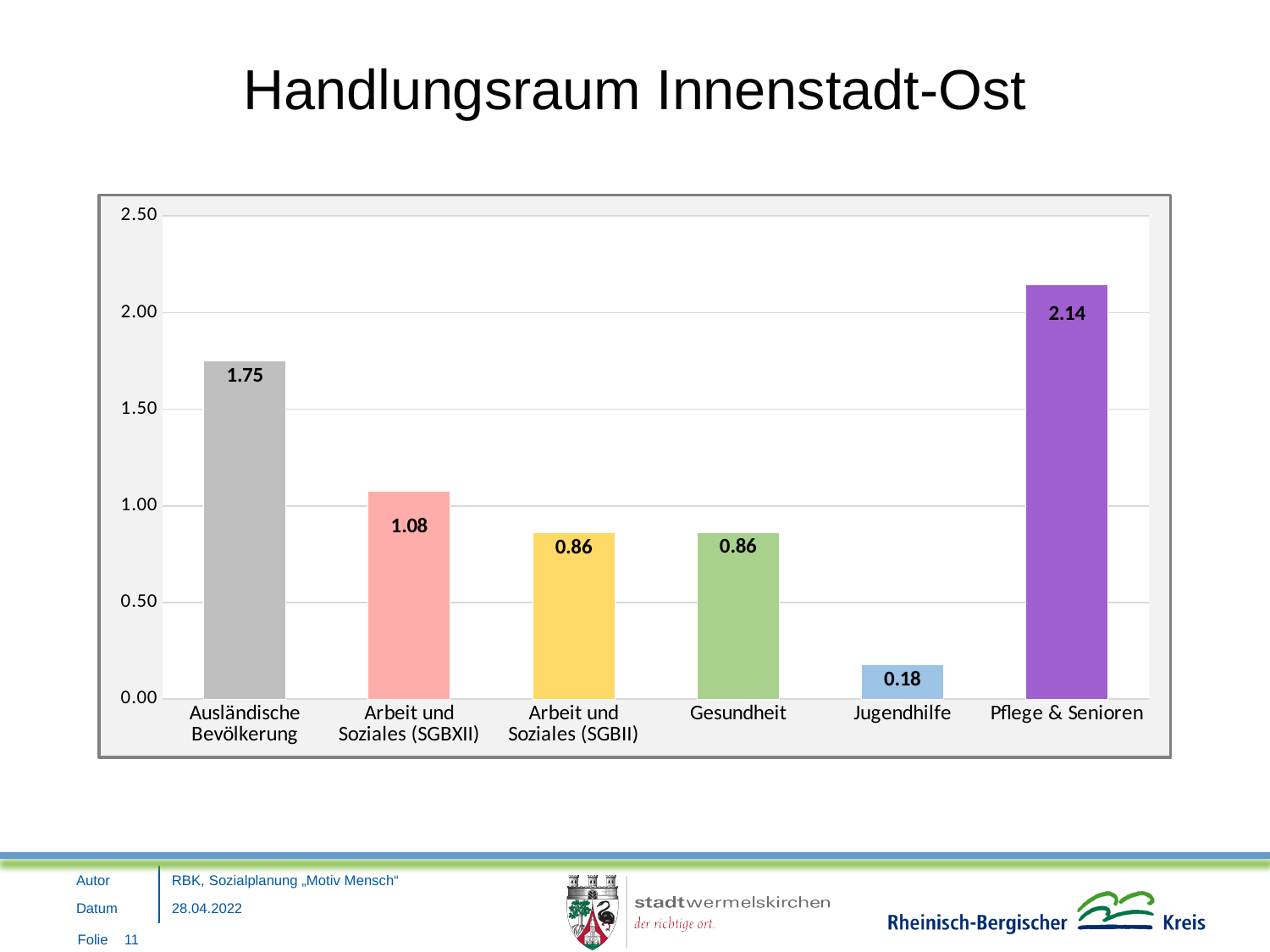
What is the difference between the values for Pflege & Senioren and Ausländische Bevölkerung? 0.39 What is the value for Pflege & Senioren? 2.14 What is the value for Jugendhilfe? 0.18 Which category has the lowest value? Jugendhilfe How many categories are shown on the x axis? 6 What colour is the bar for Pflege & Senioren? Purple Which is larger, the value for Arbeit und Soziales (SGBXII) or the value for Gesundheit? Arbeit und Soziales (SGBXII) What is the title of the slide? Handlungsraum Innenstadt-Ost What is the value for Ausländische Bevölkerung? 1.75 What is the value for Arbeit und Soziales (SGBXII)? 1.08 Which category has the highest value? Pflege & Senioren What kind of chart is shown on the slide? Bar chart